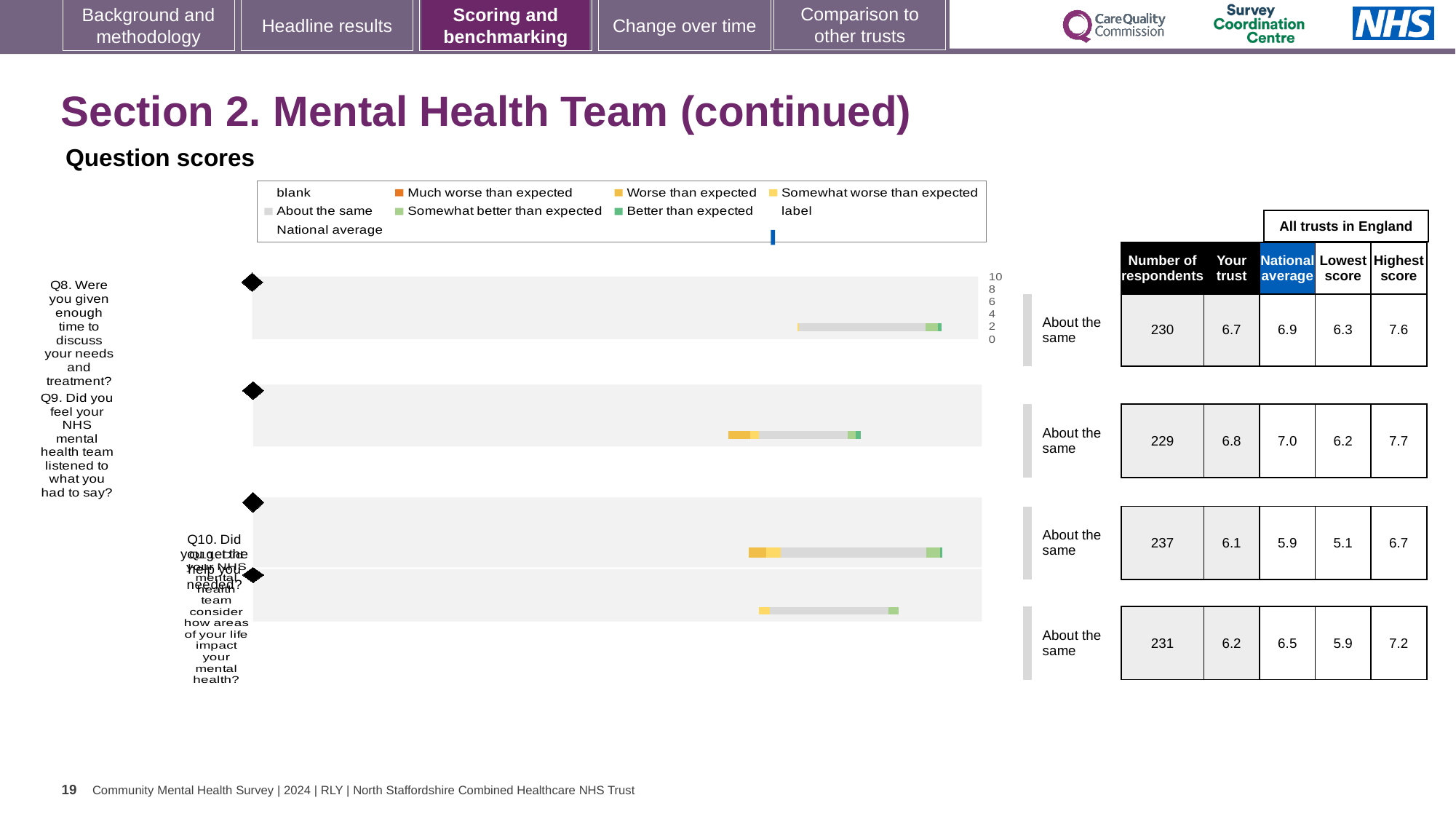
Which question has the smallest number of respondents in the table? Q9 Which question has the largest number of respondents in the table? Q10 What is the difference between the 'Your trust' score and the national average for Q10? 0.2 What is the national average score for Q10 (Did you get the help you needed)? 5.9 Which legend entry is shown in orange in the question scores chart? Much worse than expected What benchmark label is shown next to the Q9 bar? About the same How many question bars are plotted in the question scores chart? 4 For Q8, which is larger: the 'Your trust' score or the national average? National average What is the highest score across all trusts in England for the bottom (fourth) question row? 7.2 In the table beside the chart, what is the number of respondents for Q8 (Were you given enough time to discuss your needs and treatment)? 230 What kind of chart is used to show the question scores on this slide? bar chart What is the 'Your trust' score for Q9 (Did you feel your NHS mental health team listened to what you had to say)? 6.8